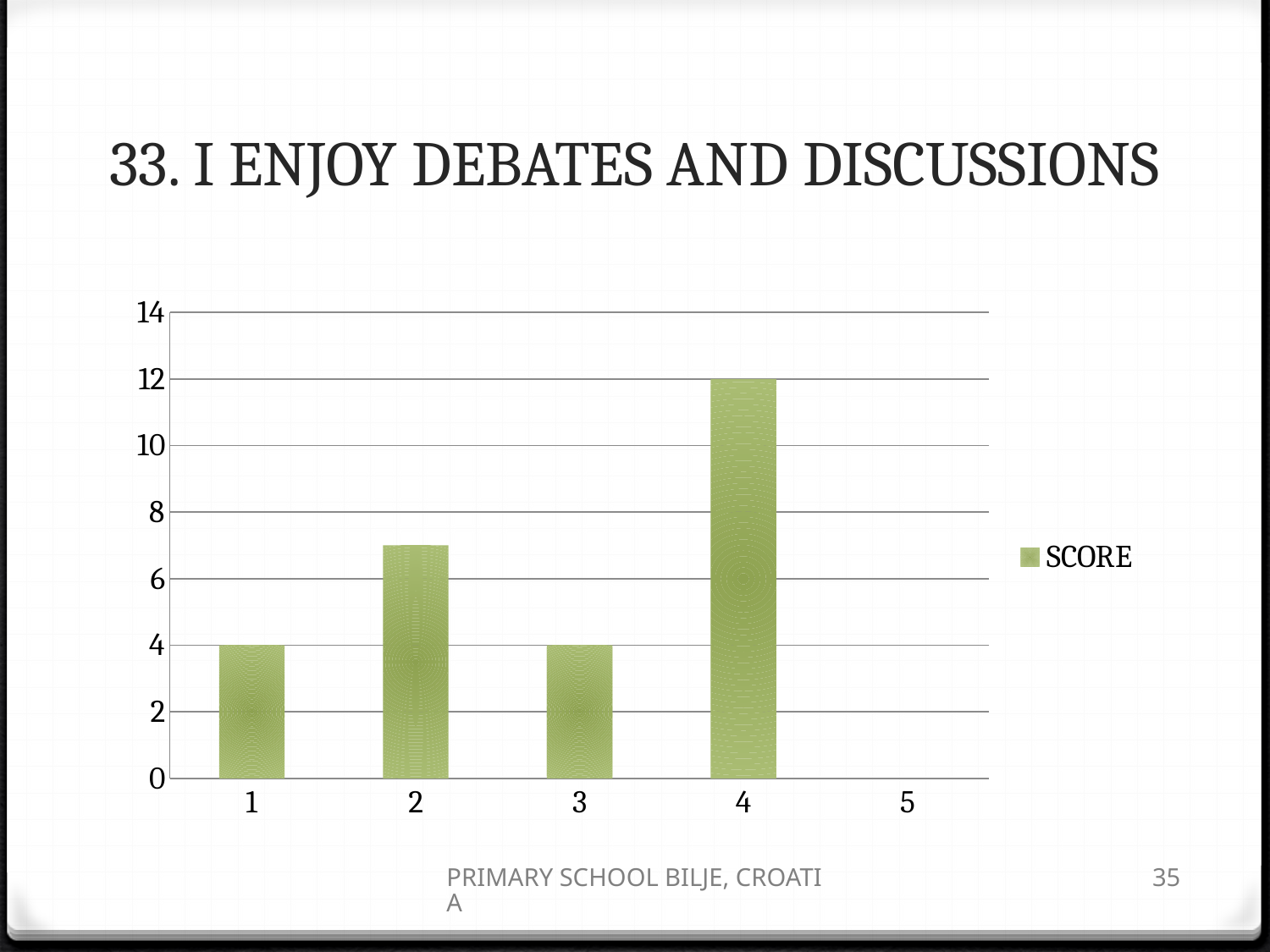
How many categories are shown on the x axis? 5 What is the value for category 4? 12 What kind of chart is shown on the slide? bar chart Is the value for category 2 greater or less than 6? greater What is the value for category 3? 4 Which category has the highest value? 4 What is the value for category 5? 0 What is the difference between the values for category 4 and category 1? 8 Is the value for category 2 greater or less than 8? less What is the value for category 1? 4 Which category has the lowest value? 5 Which has a larger value, category 2 or category 3? 2